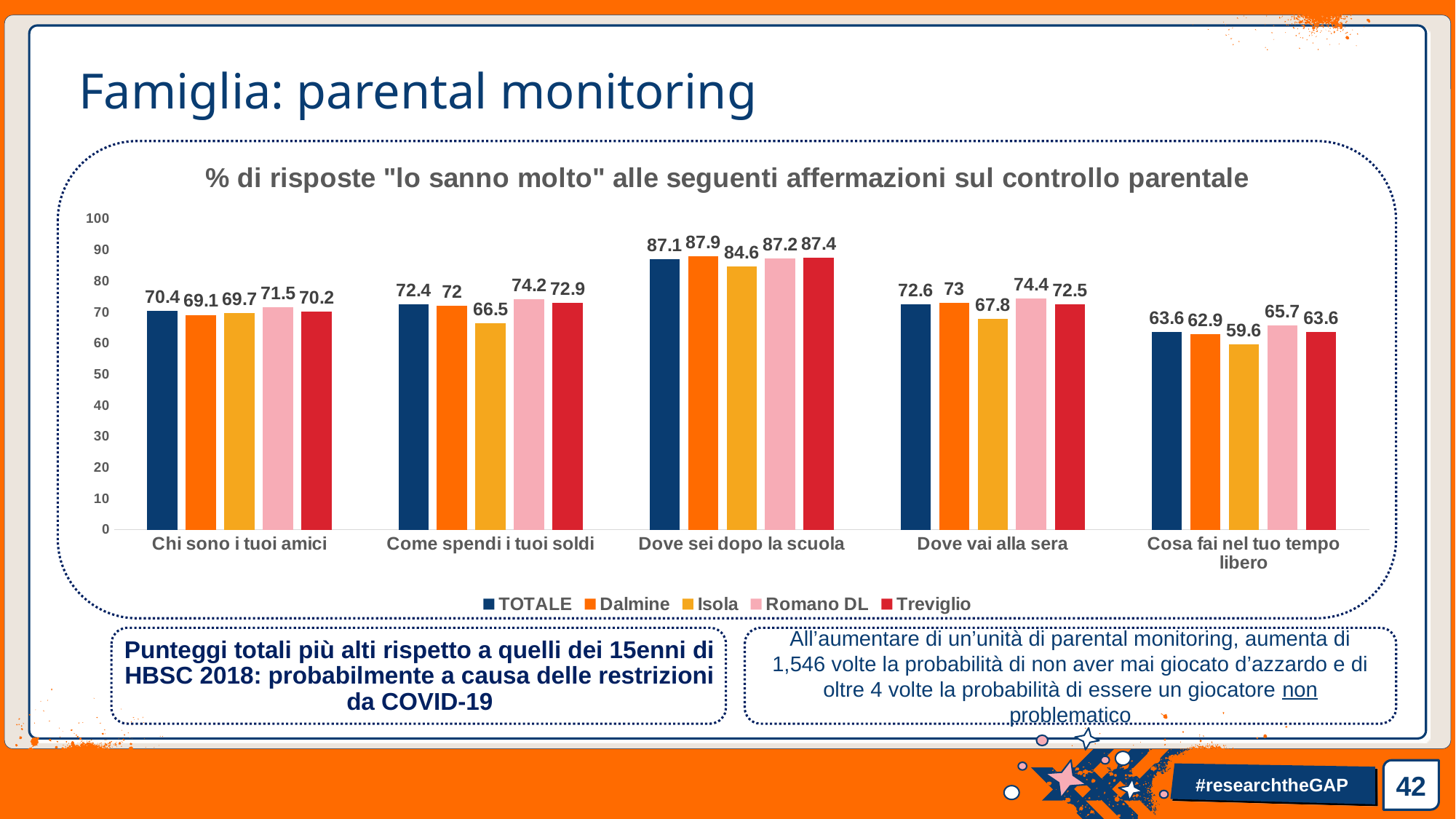
What is the difference between the Dalmine and Isola values for "Dove sei dopo la scuola"? 3.3 For "Chi sono i tuoi amici", which is larger: the Romano DL value or the Dalmine value? Romano DL What is the Romano DL value for "Cosa fai nel tuo tempo libero"? 65.7 What is the Isola value for "Come spendi i tuoi soldi"? 66.5 How many categories are shown on the x axis? 5 Which category has the lowest Isola value? Cosa fai nel tuo tempo libero Which category has the highest TOTALE value? Dove sei dopo la scuola What is the TOTALE value for "Dove sei dopo la scuola"? 87.1 How many series does the legend list? 5 What kind of chart is shown on the slide? bar chart Is the Treviglio value for "Cosa fai nel tuo tempo libero" greater or less than 70? less What is the Dalmine value for "Dove vai alla sera"? 73